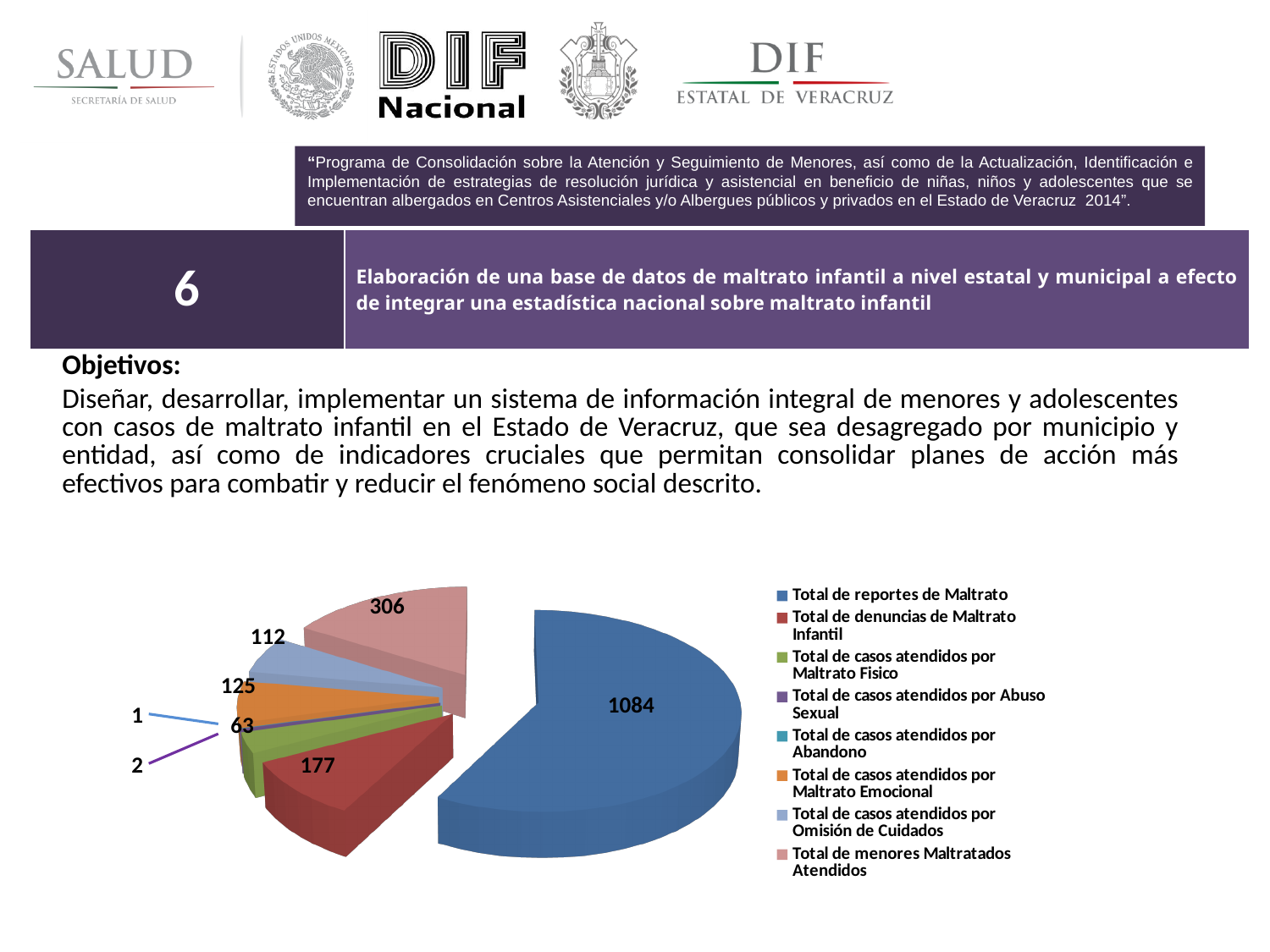
What is the value for Total de reportes de Maltrato? 1084 What type of chart is shown on the slide? Pie chart What colour is the slice for Total de menores Maltratados Atendidos? Pink What is the difference between Total de menores Maltratados Atendidos and Total de denuncias de Maltrato Infantil? 129 Which is larger: Total de casos atendidos por Maltrato Emocional or Total de casos atendidos por Omisión de Cuidados? Total de casos atendidos por Maltrato Emocional How many slices does the pie chart have? 8 What is the value for Total de casos atendidos por Omisión de Cuidados? 112 What is the value for Total de denuncias de Maltrato Infantil? 177 Which category has the largest slice of the pie? Total de reportes de Maltrato Which category has the smallest value in the pie chart? Total de casos atendidos por Abandono What is the value for Total de menores Maltratados Atendidos? 306 What is the value for Total de casos atendidos por Maltrato Emocional? 125